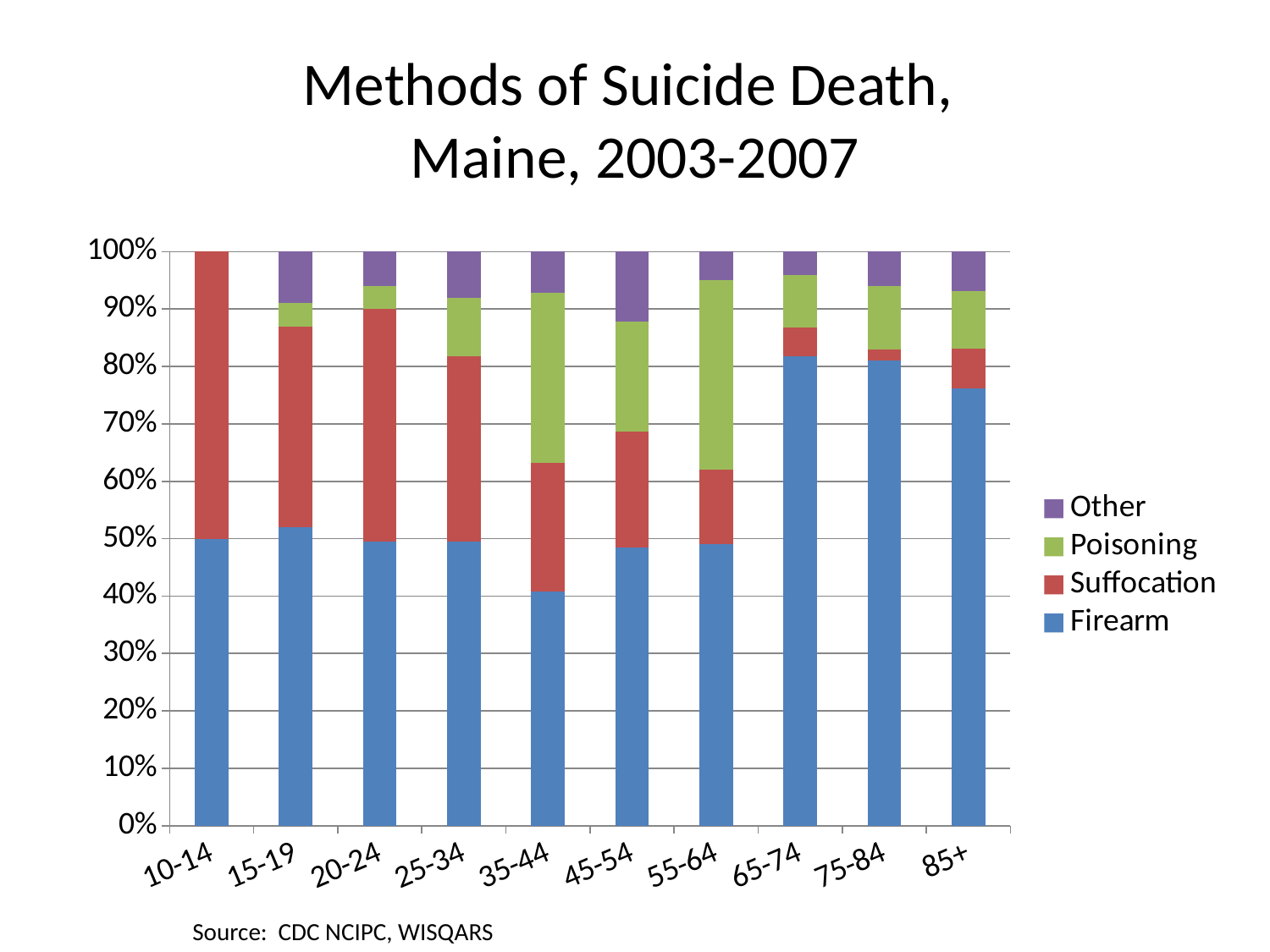
Which has the larger Suffocation share, the 10-14 age group or the 85+ age group? 10-14 How many series does the legend list? 4 Is the Firearm share for the 65-74 age group greater or less than 70%? greater How many age groups are shown on the x axis? 10 Is the Firearm share for the 85+ age group greater or less than 70%? greater What kind of chart is shown on the slide? stacked bar chart What is the title of the chart? Methods of Suicide Death, Maine, 2003-2007 Is the Firearm share for the 35-44 age group greater or less than 50%? less Which age group has the lowest Firearm share? 35-44 Which has the larger Firearm share, the 65-74 age group or the 35-44 age group? 65-74 What does each stacked bar total? 100% Which age group's bar shows only Firearm and Suffocation, with no Poisoning or Other segment? 10-14